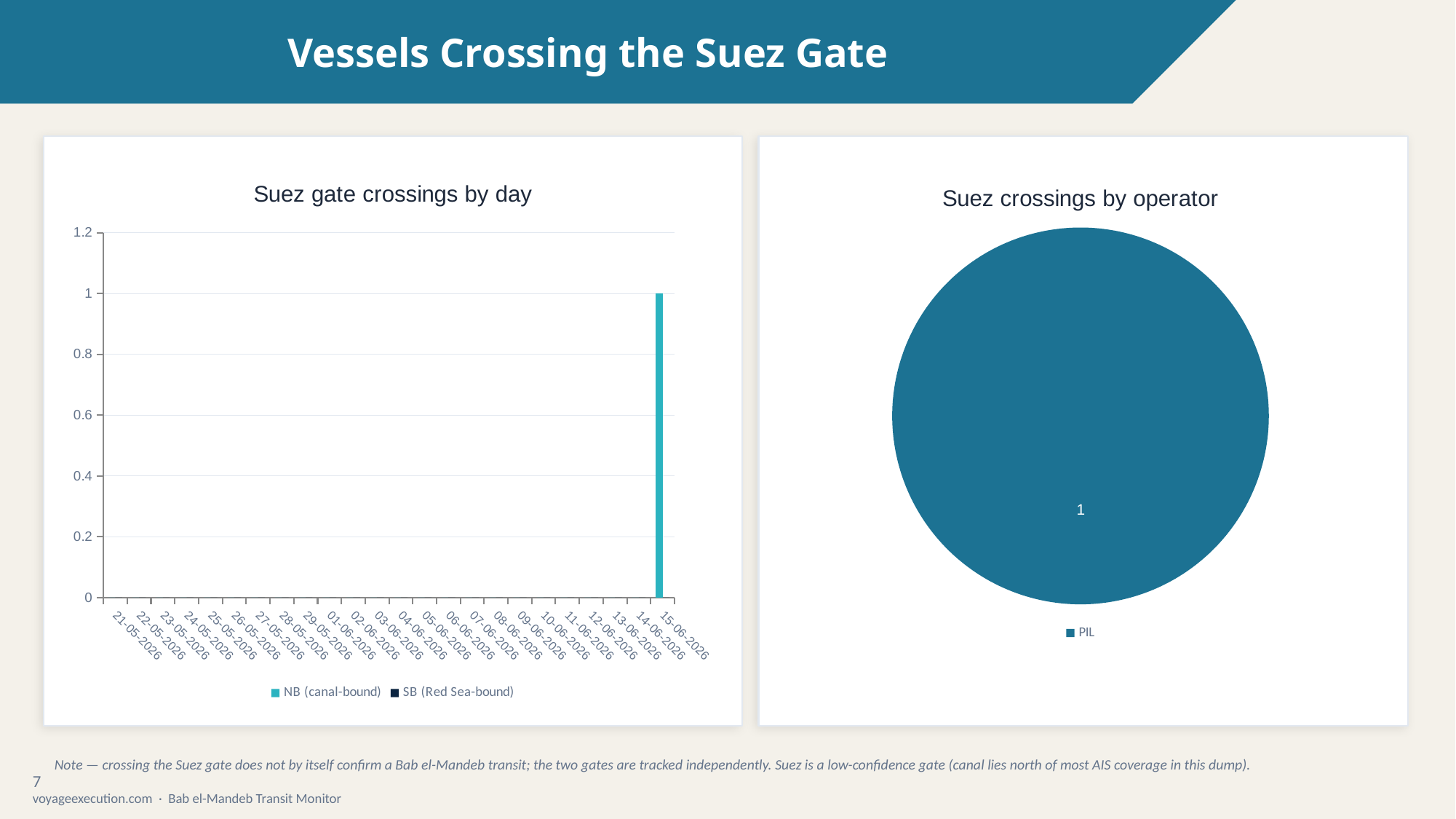
What kind of chart is "Suez gate crossings by day"? bar chart In "Suez crossings by operator", what share of the pie does PIL represent? 100% In "Suez gate crossings by day", what is the NB (canal-bound) value on 15-06-2026? 1 What is the title of the pie chart on the right of the slide? Suez crossings by operator In "Suez gate crossings by day", what are the two legend entries? NB (canal-bound) and SB (Red Sea-bound) In "Suez gate crossings by day", is the NB (canal-bound) value on 15-06-2026 greater or less than 0.8? greater In "Suez gate crossings by day", how many dates are shown on the x axis? 24 In "Suez crossings by operator", how many slices does the pie have? 1 In "Suez gate crossings by day", how many series does the legend list? 2 In "Suez crossings by operator", what is the value shown for PIL? 1 In "Suez gate crossings by day", which date has the highest NB (canal-bound) value? 15-06-2026 What kind of chart is "Suez crossings by operator"? pie chart